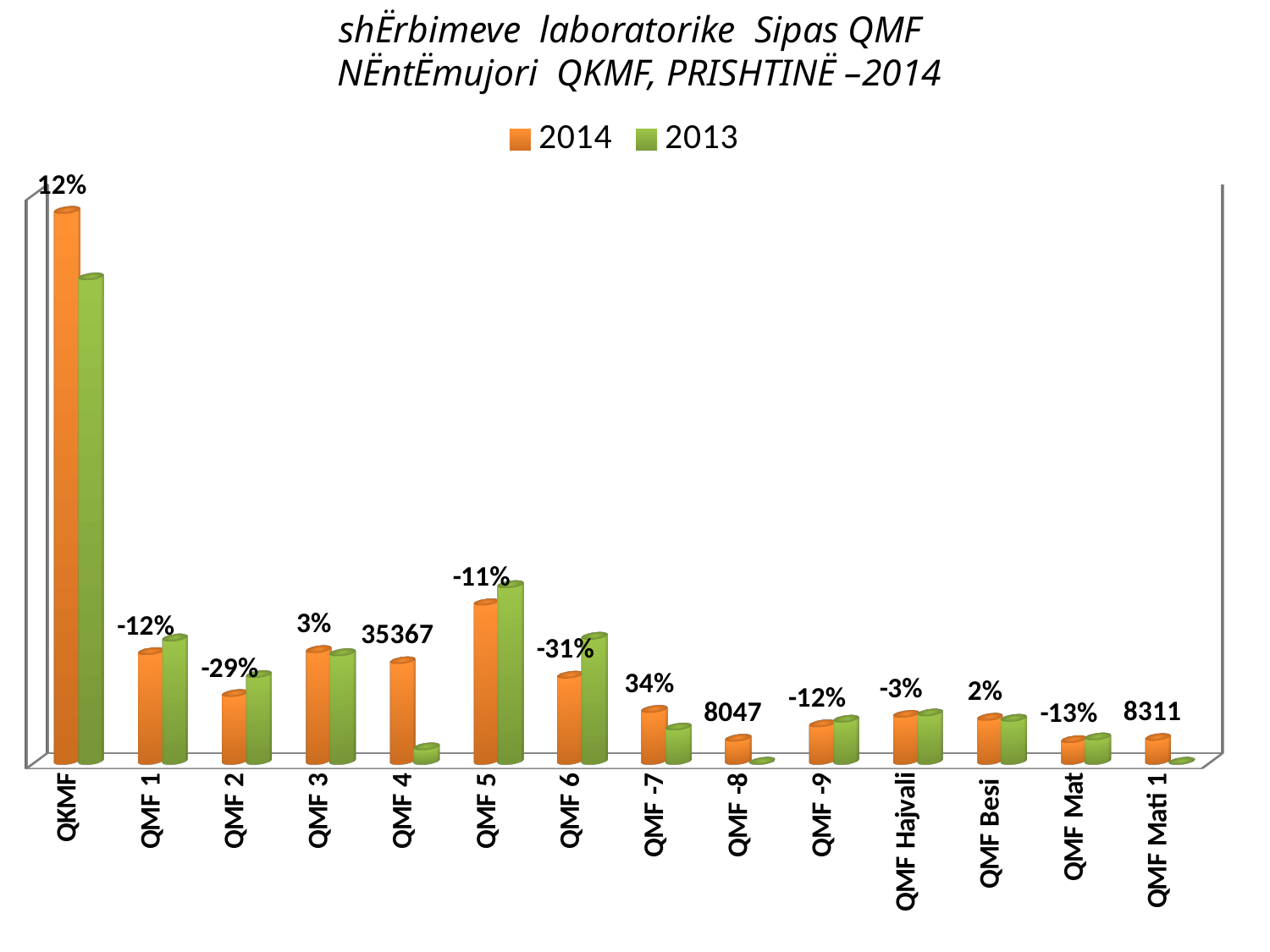
What label is printed above the bars for QMF 4? 35367 For QMF 4, which bar is taller, 2014 or 2013? 2014 Which category has the tallest 2014 bar? QKMF What label is printed above the bars for QMF 6? -31% Which category has the tallest 2013 bar? QKMF How many series does the legend list? 2 Which two series are listed in the legend? 2014 and 2013 How many categories are shown along the x axis? 14 What label is printed above the bars for QMF -8? 8047 What label is printed above the bars for QKMF? 12% For QMF 5, which bar is taller, 2014 or 2013? 2013 What kind of chart is shown on the slide? bar chart